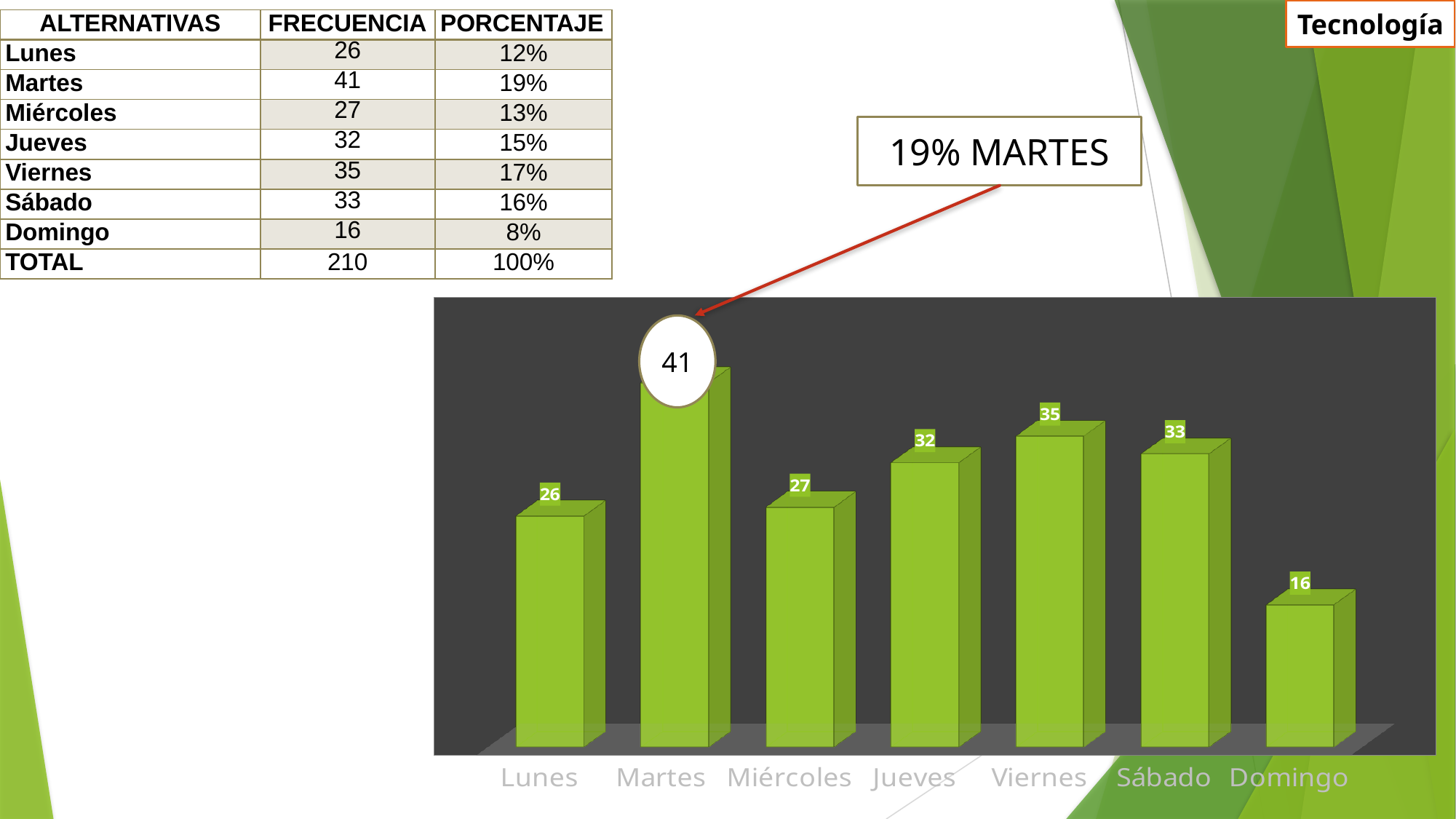
Which day has the lowest value in the bar chart? Domingo What does the callout box above the chart say? 19% MARTES What kind of chart is shown on the slide? bar chart What is the value for Domingo in the bar chart? 16 Which day has the highest value in the bar chart? Martes What is the difference between the values for Viernes and Sábado? 2 What is the value for Martes in the bar chart? 41 Do the values rise or fall from Viernes to Domingo? fall Which has a larger value, Jueves or Miércoles? Jueves What is the difference between the values for Martes and Lunes? 15 How many categories are shown on the x axis of the bar chart? 7 What is the value for Viernes in the bar chart? 35